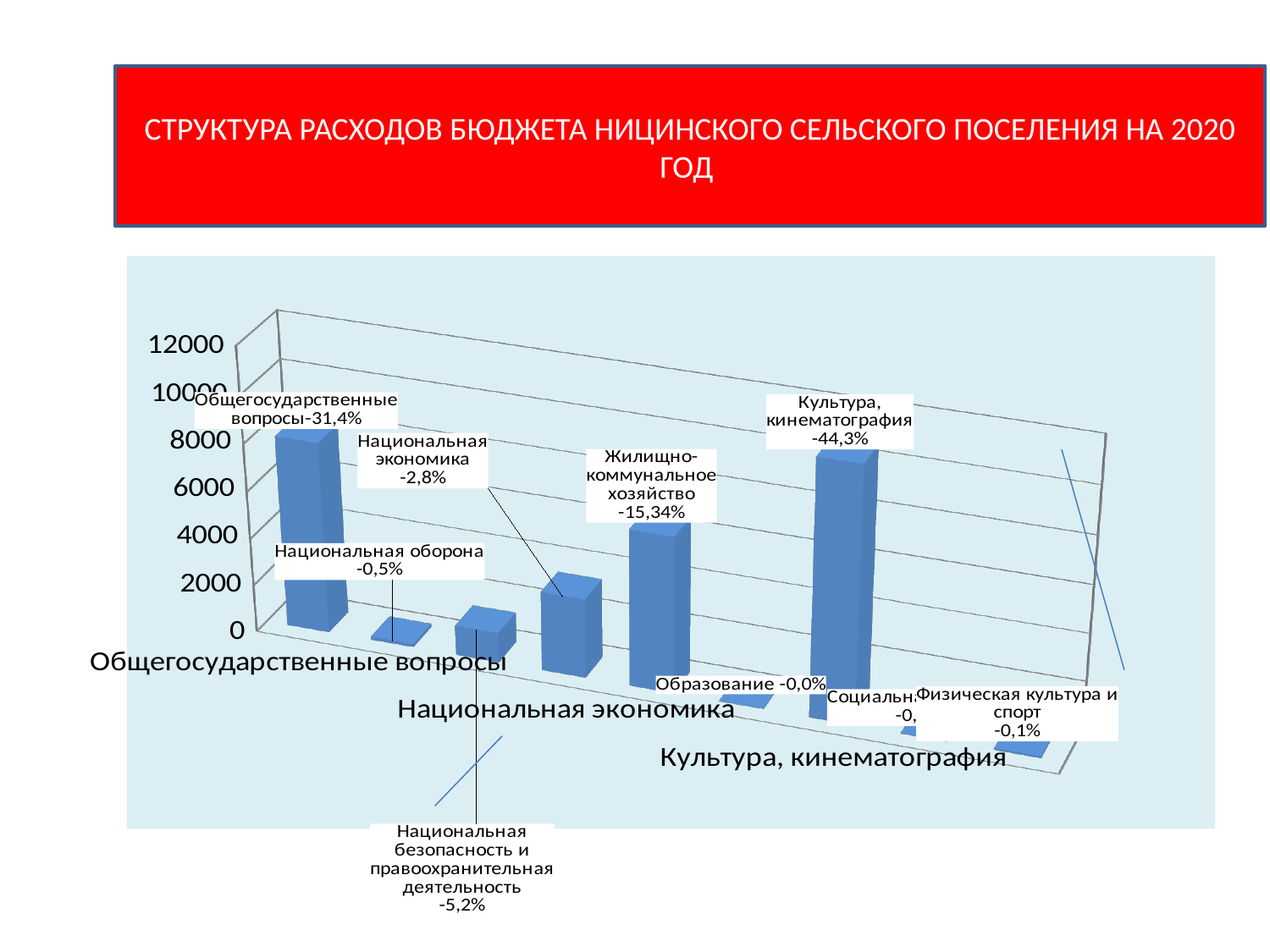
What share is labelled for Жилищно-коммунальное хозяйство? 15,34% What share is labelled for Национальная оборона? 0,5% What share of expenditure is labelled for Культура, кинематография? 44,3% What share is labelled for Общегосударственные вопросы? 31,4% Which is larger: the share for Общегосударственные вопросы or for Жилищно-коммунальное хозяйство? Общегосударственные вопросы What share is labelled for Национальная безопасность и правоохранительная деятельность? 5,2% Which category is labelled with the smallest share, 0,0%? Образование What share is labelled for Национальная экономика? 2,8% What is the difference in percentage points between the shares for Культура, кинематография and Общегосударственные вопросы? 12,9 What kind of chart is shown on the slide? bar chart Which category has the largest share of expenditure? Культура, кинематография Is the bar for Национальная оборона greater or less than 2000? less